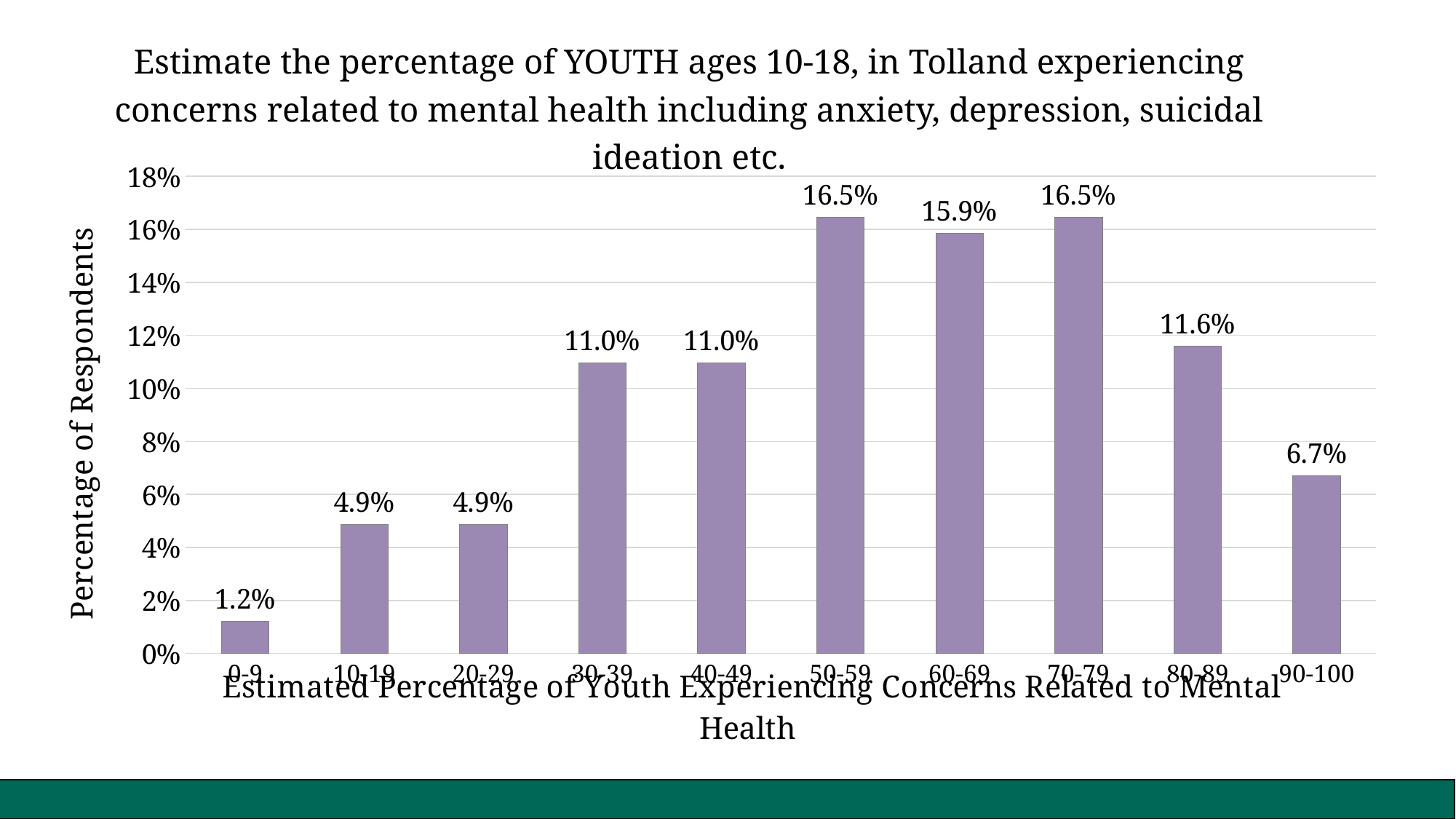
What percentage of respondents chose the 80-89 range? 11.6% What kind of chart is shown on the slide? Bar chart What is the difference between the percentage for 70-79 and the percentage for 80-89? 4.9% What percentage of respondents chose the 0-9 range? 1.2% Which range has the lowest percentage of respondents? 0-9 How many ranges are shown on the x axis? 10 What percentage of respondents chose the 60-69 range? 15.9% What is the difference between the percentage for 60-69 and the percentage for 90-100? 9.2% What is the label of the vertical axis? Percentage of Respondents What percentage of respondents chose the 90-100 range? 6.7% Which has a higher percentage of respondents, 50-59 or 60-69? 50-59 Which has a higher percentage of respondents, 10-19 or 90-100? 90-100